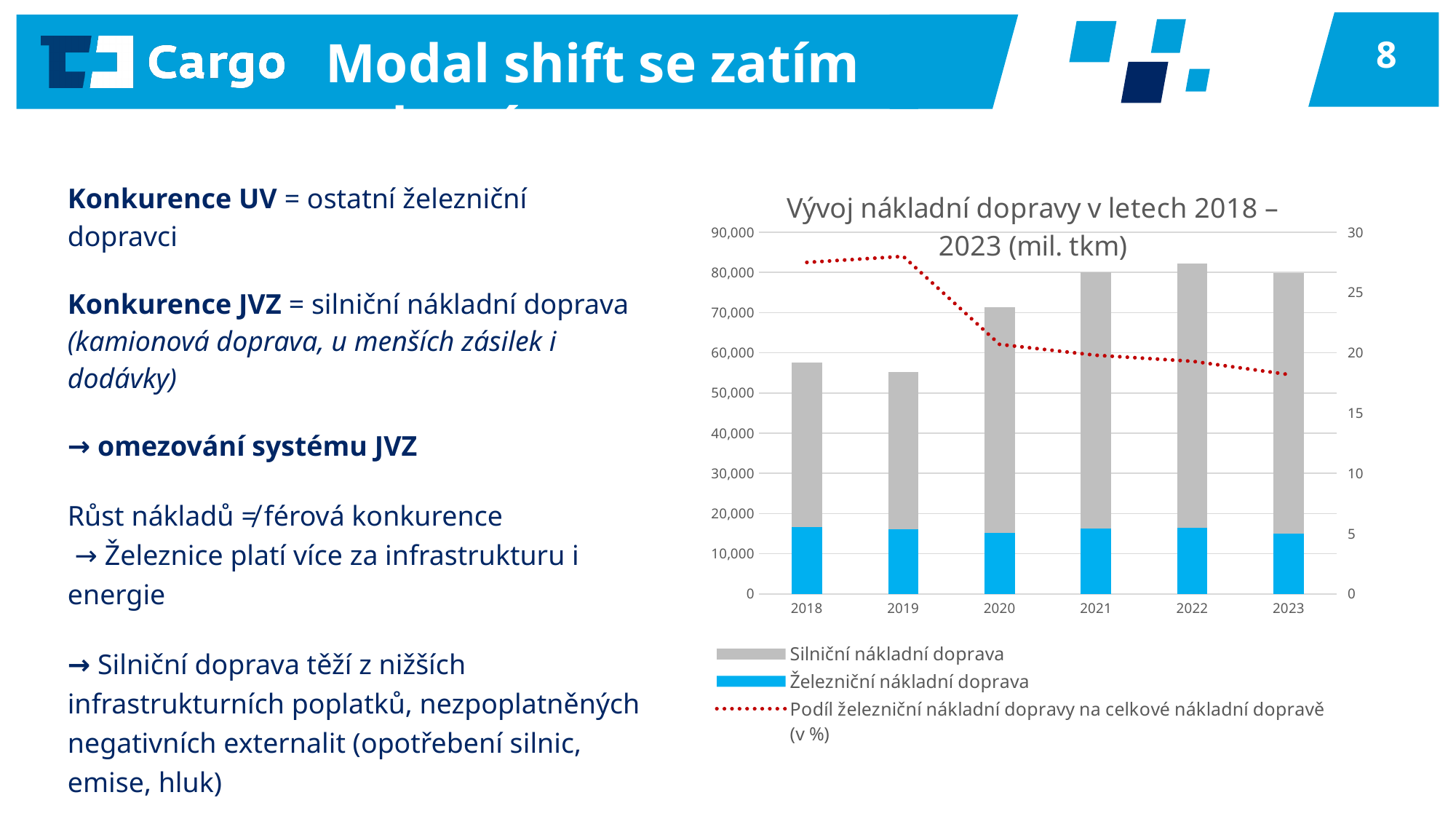
What is the title of the chart? Vývoj nákladní dopravy v letech 2018 – 2023 (mil. tkm) How many series does the chart legend list? 3 Is the value of the dotted line (Podíl železniční nákladní dopravy) for 2023 greater or less than 20? less Which year has the shortest stacked bar (lowest total freight transport)? 2019 Which year has the larger total stacked bar, 2019 or 2020? 2020 Is the value of the dotted line (Podíl železniční nákladní dopravy) for 2018 greater or less than 25? greater Does the dotted line for Podíl železniční nákladní dopravy rise or fall from 2019 to 2023? fall Which year has the tallest stacked bar (highest total freight transport)? 2022 What kind of chart is used for the Silniční nákladní doprava and Železniční nákladní doprava series? bar chart Is the total stacked bar value for 2018 greater or less than 60,000? less How many years are shown on the x axis of the chart? 6